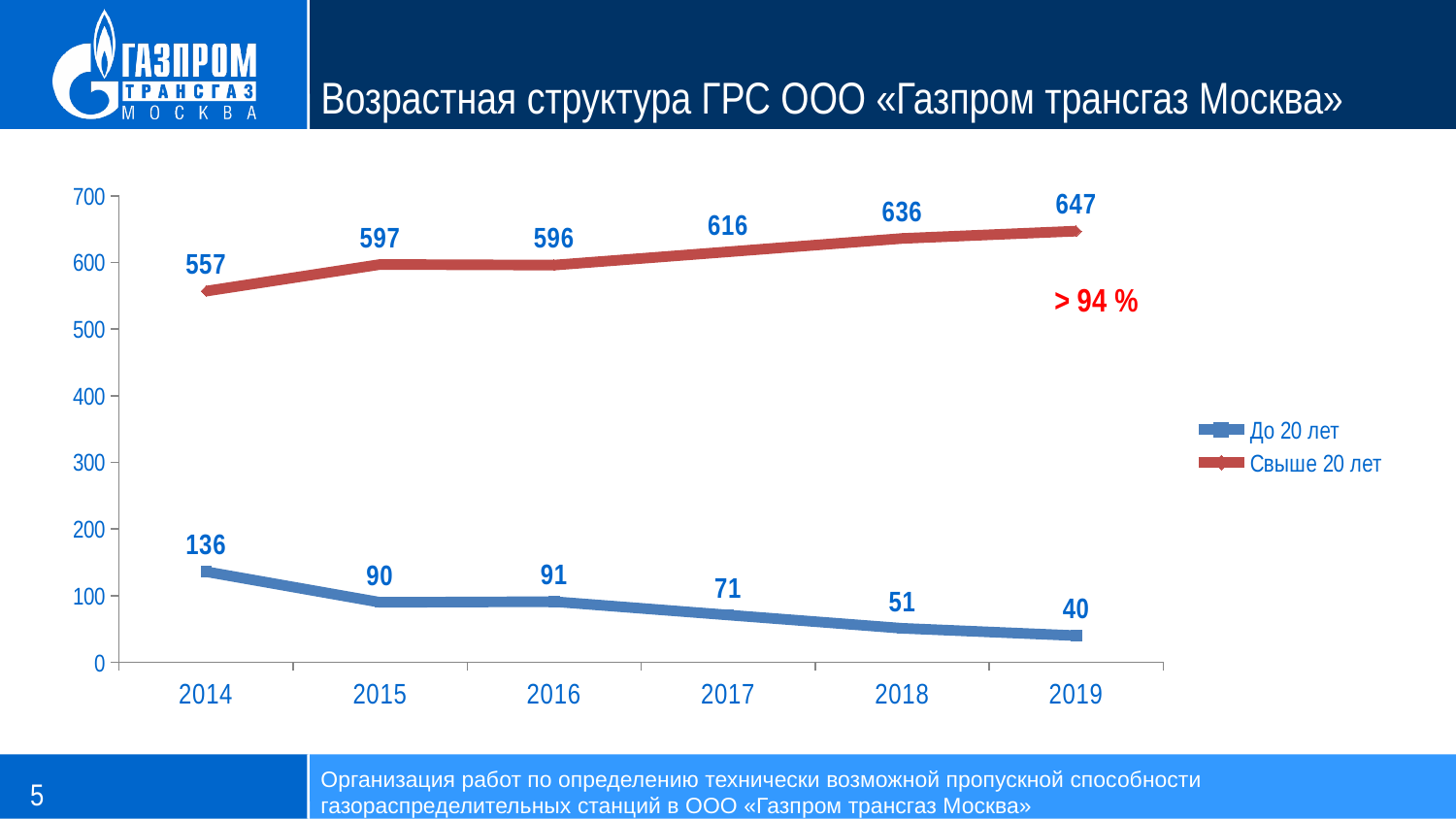
How many series does the legend list? 2 What is the value for "Свыше 20 лет" in 2019? 647 By how much did the "До 20 лет" value change from 2014 to 2015? 46 In which year is the "До 20 лет" series lowest? 2019 In which year is the "Свыше 20 лет" series highest? 2019 What kind of chart is shown on the slide? line chart What is the value for "До 20 лет" in 2017? 71 What is the value for "До 20 лет" in 2014? 136 Which is larger: the "Свыше 20 лет" value in 2015 or in 2018? 2018 What is the difference between the "Свыше 20 лет" and "До 20 лет" values in 2019? 607 How many years are shown on the x axis? 6 Does the "До 20 лет" series rise or fall from 2014 to 2019? fall